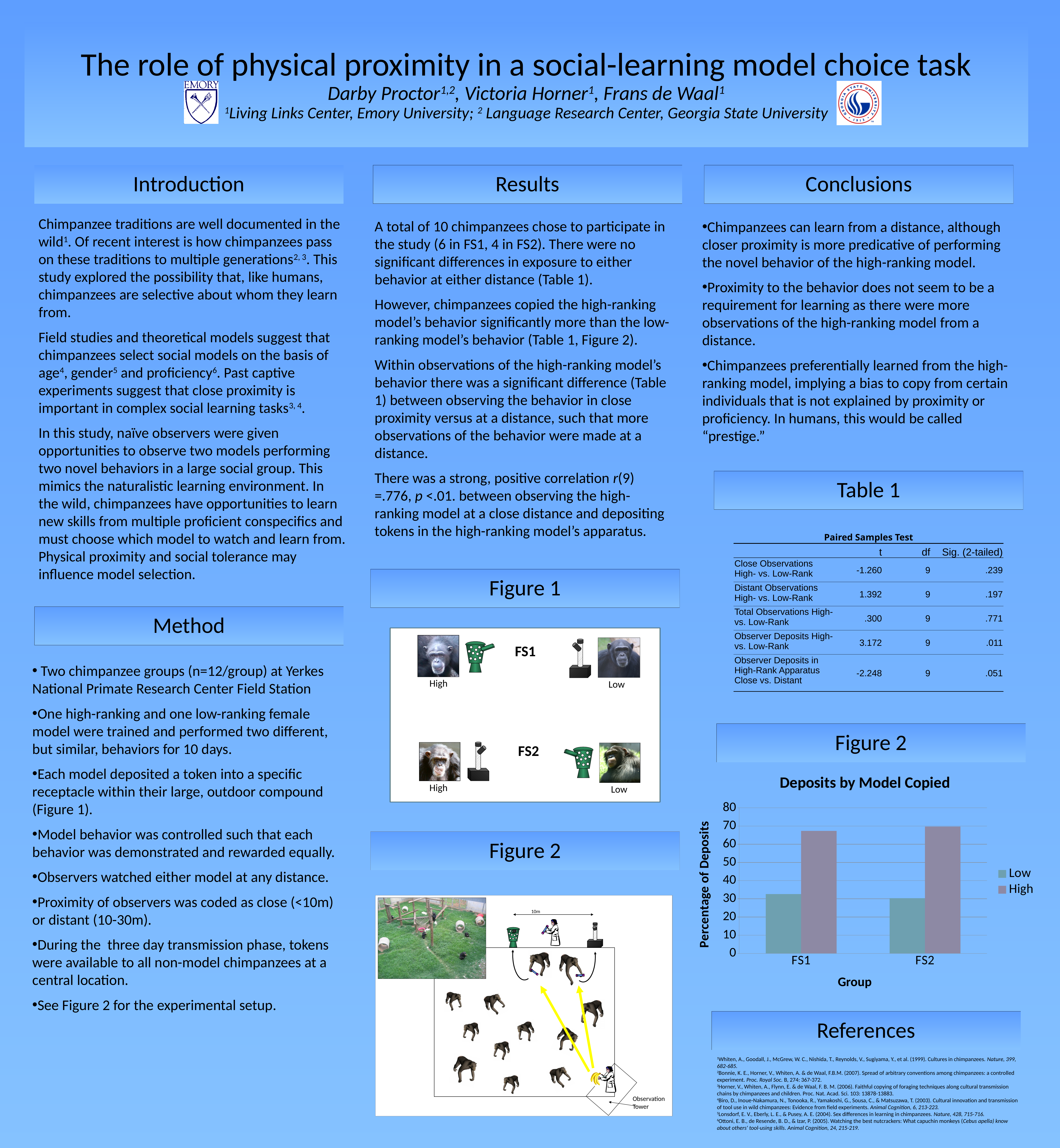
In the 'Deposits by Model Copied' chart, is the Low value for FS1 greater or less than 40? less What kind of chart is Figure 2 'Deposits by Model Copied'? bar chart In the 'Deposits by Model Copied' chart, which is larger for FS1: Low or High? High What is the title of the bar chart in Figure 2? Deposits by Model Copied How many series does the legend of the 'Deposits by Model Copied' chart list? 2 In the 'Deposits by Model Copied' chart, is the Low value for FS2 greater or less than 40? less In the 'Deposits by Model Copied' chart, is the High value for FS2 greater or less than 60? greater In the 'Deposits by Model Copied' chart, which is larger for FS2: Low or High? High What is the y-axis label of the 'Deposits by Model Copied' chart? Percentage of Deposits How many groups are shown on the x axis of the 'Deposits by Model Copied' chart? 2